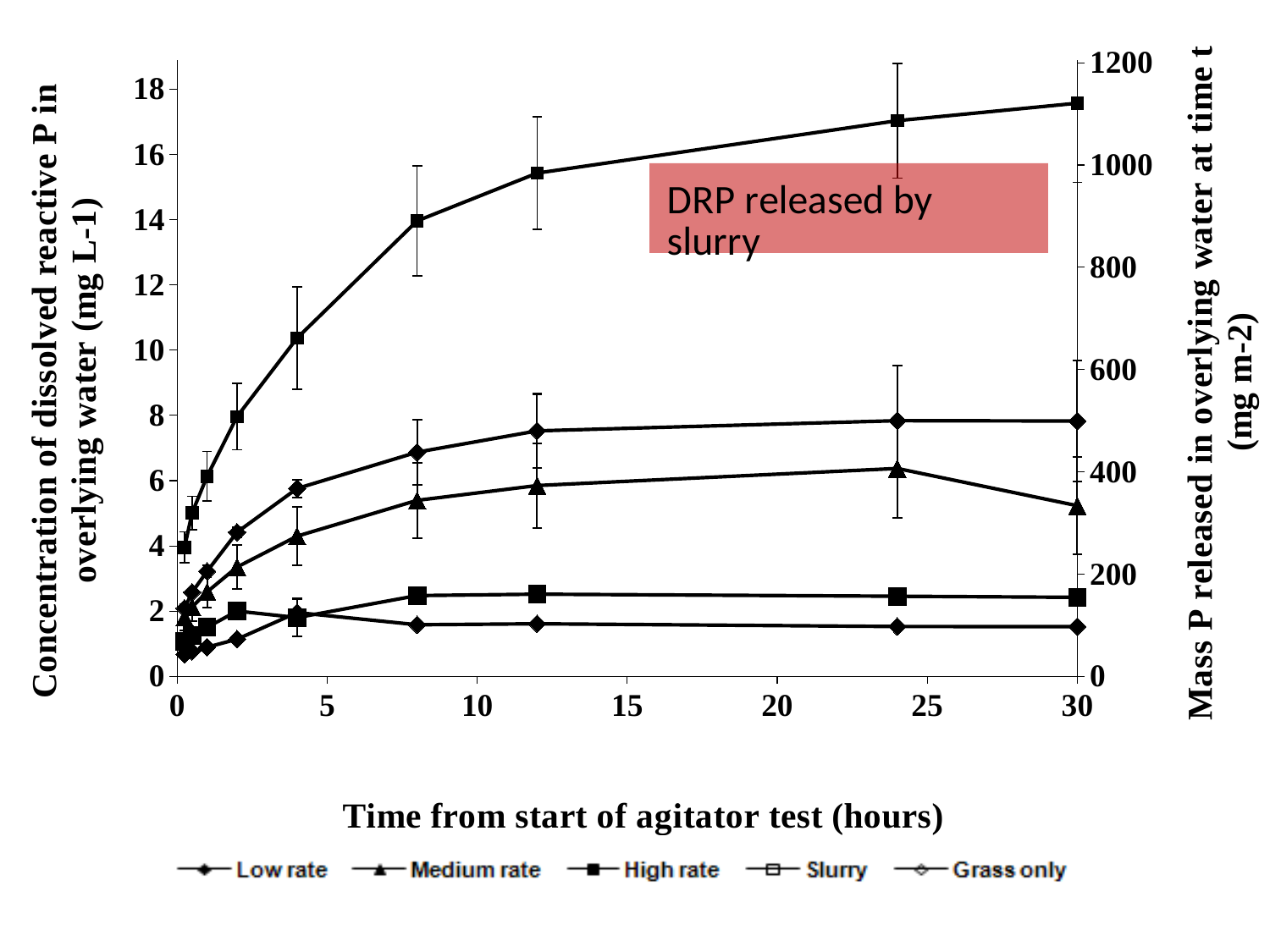
What is the highest tick value shown on the x axis? 30 How many series does the legend list? 5 Is the Low rate value at 24 hours greater or less than 6 mg L-1 on the left axis? greater Is the High rate value at 30 hours greater or less than 16 mg L-1 on the left axis? less At 30 hours, which is larger: the Low rate value or the Medium rate value? Low rate Does the High rate series rise or fall as time increases from 0 to 30 hours? rise Which series has the highest value at 30 hours? Slurry What kind of chart is shown on the slide? line chart Is the Low rate value at 24 hours greater or less than 10 mg L-1 on the left axis? less What is the title of the x axis? Time from start of agitator test (hours) What is the highest tick value shown on the right-hand y axis? 1200